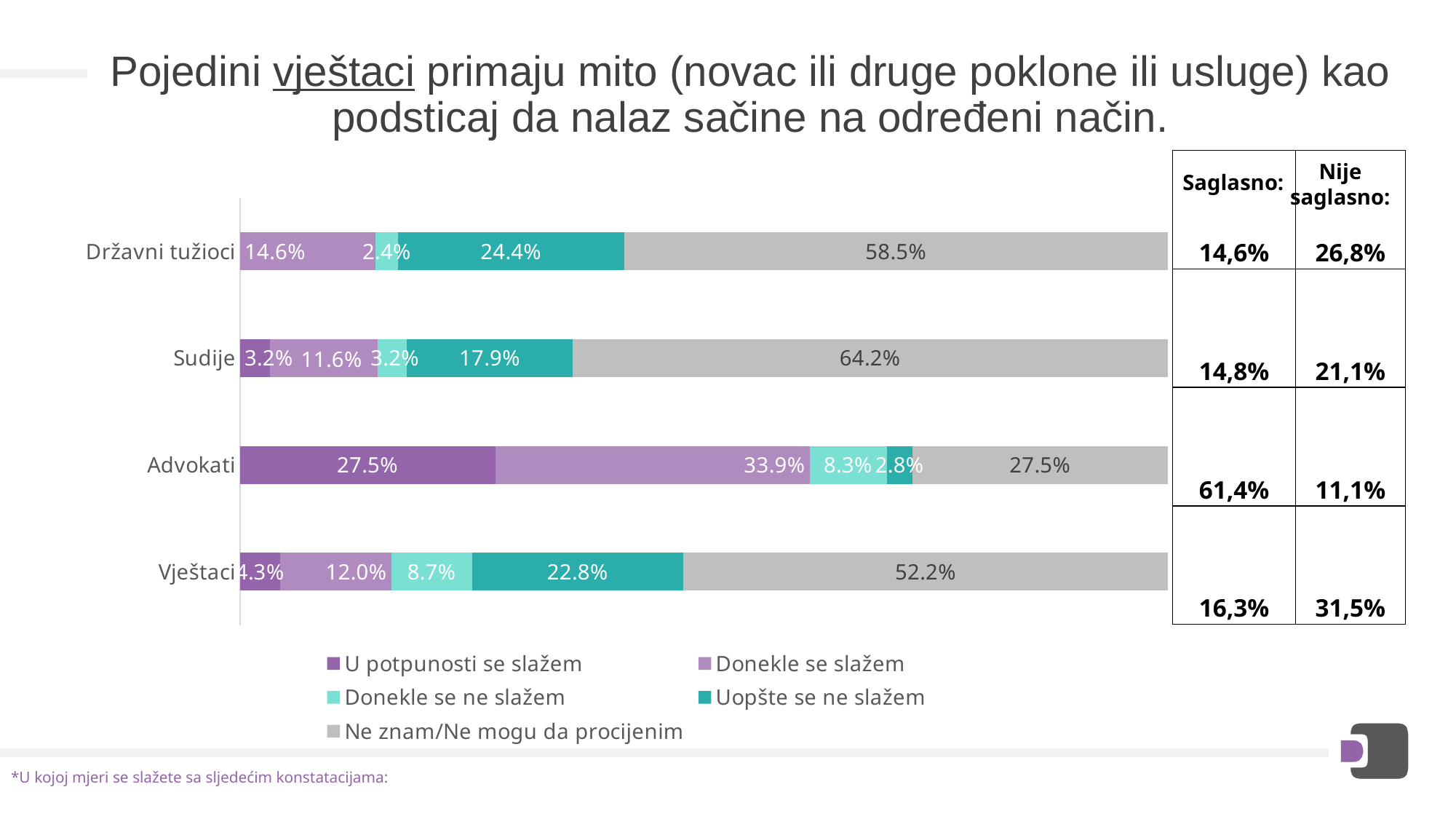
What is the value for Sudije in the 'Ne znam/Ne mogu da procijenim' series? 64.2% Which category has the lowest value in the 'Ne znam/Ne mogu da procijenim' series? Advokati Which has a larger 'Uopšte se ne slažem' value, Državni tužioci or Vještaci? Državni tužioci What kind of chart is shown on the slide? Stacked bar chart How many categories are shown on the chart? 4 What is the value for Advokati in the 'Donekle se slažem' series? 33.9% What is the value for Advokati in the 'U potpunosti se slažem' series? 27.5% What is the difference between the 'Ne znam/Ne mogu da procijenim' values for Sudije and Vještaci? 12.0% How many series does the legend list? 5 For Advokati, what is the difference between the 'Donekle se slažem' and 'U potpunosti se slažem' values? 6.4% Which category has the highest value in the 'Ne znam/Ne mogu da procijenim' series? Sudije What is the value for Vještaci in the 'Uopšte se ne slažem' series? 22.8%